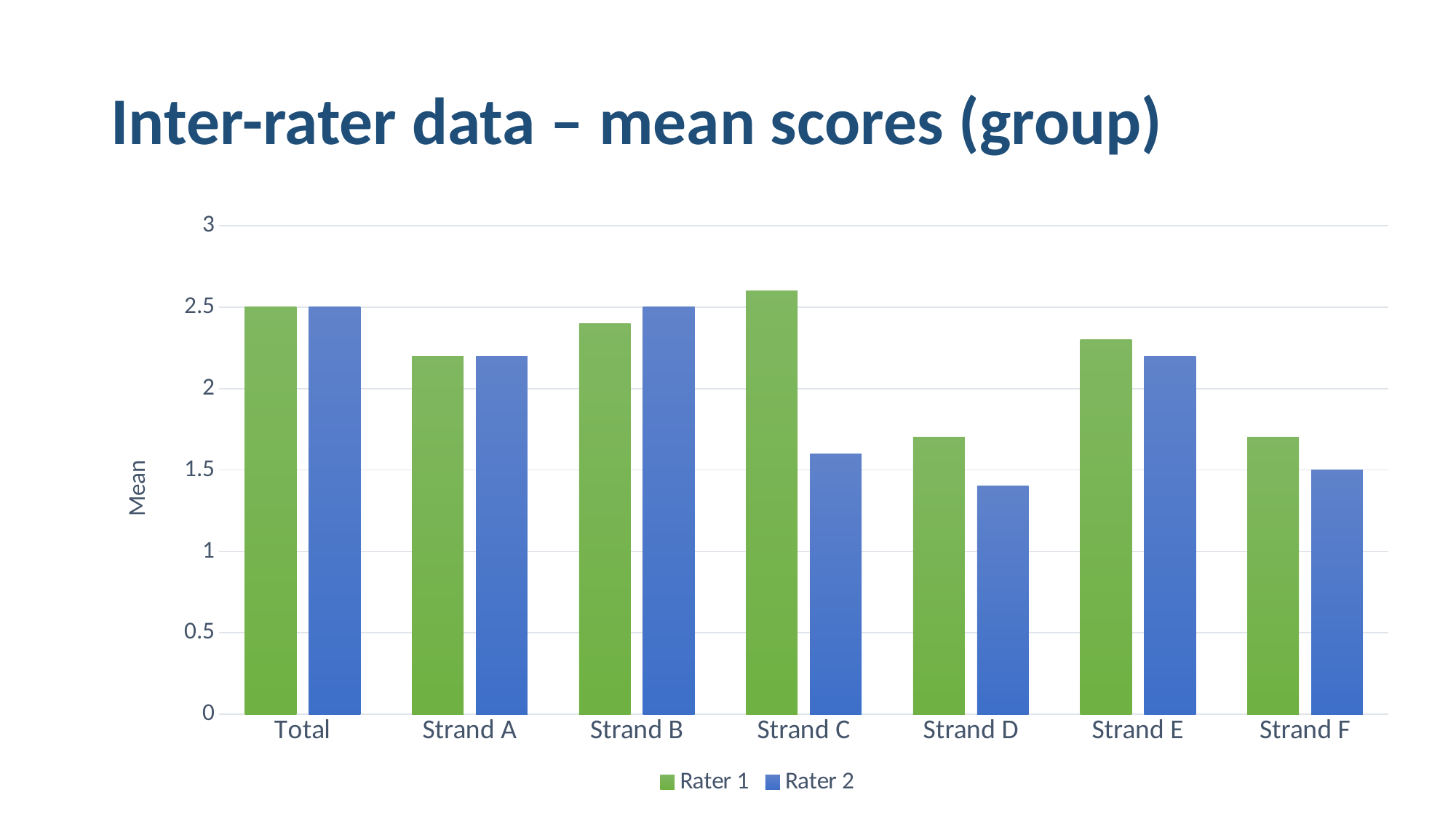
How many series does the legend list? 2 For Strand C, which rater has the higher mean score? Rater 1 Is the Rater 1 value for Strand D greater or less than 1.5? greater Is the Rater 2 value for Strand E greater or less than 2? greater Which category has the highest Rater 1 mean score? Strand C What is the Rater 2 mean score for Strand B? 2.5 What is the label on the vertical axis? Mean How many categories are shown on the x axis? 7 What kind of chart is shown on the slide? Bar chart What is the Rater 2 mean score for Strand F? 1.5 What is the Rater 1 mean score for Total? 2.5 Which category has the lowest Rater 2 mean score? Strand D